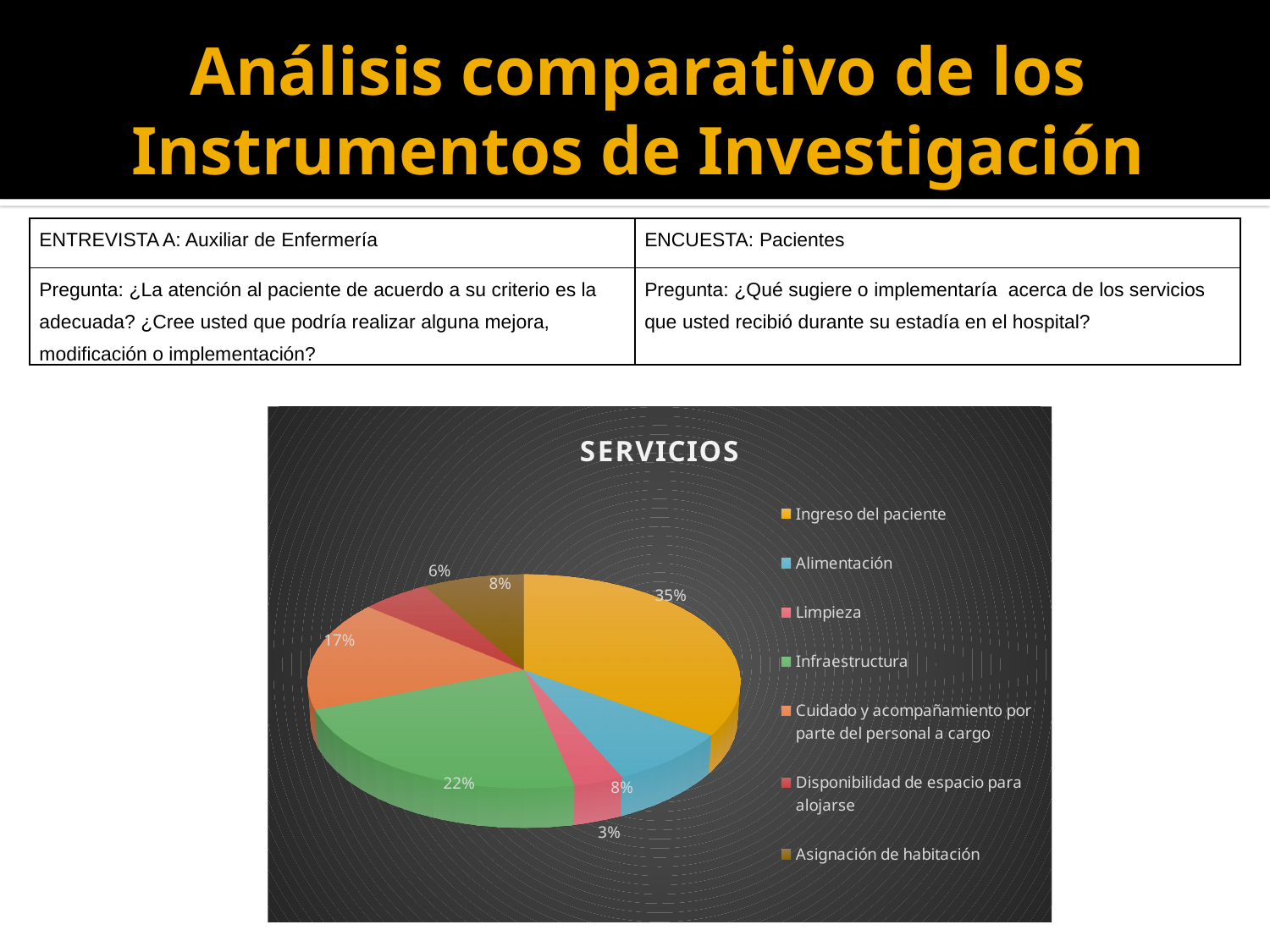
What kind of chart is shown on the slide? pie chart What share of the SERVICIOS pie does Ingreso del paciente have? 35% What is the difference in percentage points between Ingreso del paciente and Infraestructura in the SERVICIOS pie chart? 13% Which is larger in the SERVICIOS pie chart, Infraestructura or Cuidado y acompañamiento por parte del personal a cargo? Infraestructura What share of the SERVICIOS pie does Infraestructura have? 22% What share of the SERVICIOS pie does Limpieza have? 3% What is the title of the chart? SERVICIOS How many categories does the legend of the SERVICIOS pie chart list? 7 Which category has the smallest slice in the SERVICIOS pie chart? Limpieza Which category has the largest slice in the SERVICIOS pie chart? Ingreso del paciente